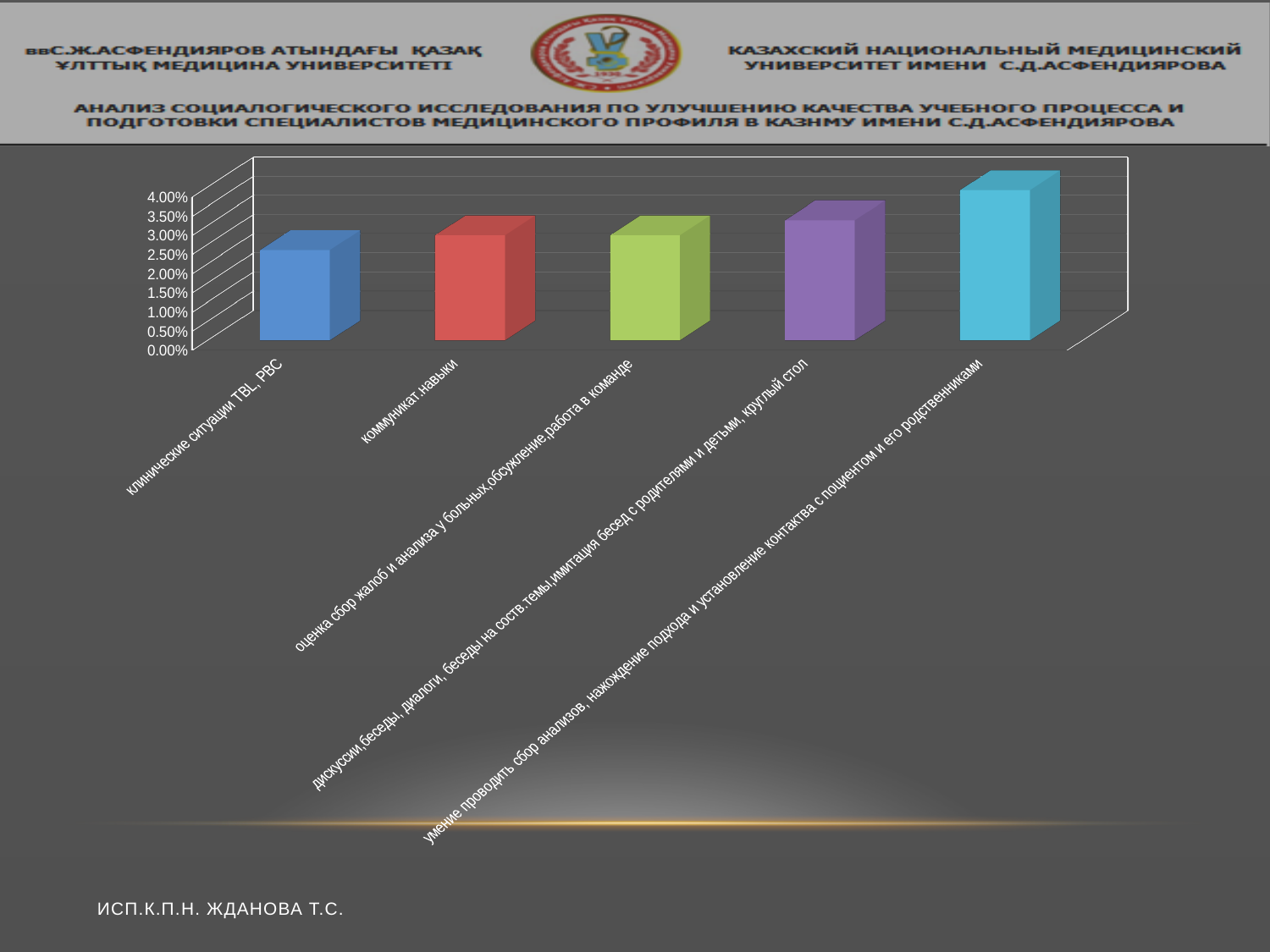
Which is larger: the value for 'клинические ситуации TBL, PBC' or the value for 'коммуникат.навыки'? коммуникат.навыки Is the value for 'умение проводить сбор анализов, нахождение подхода и установление контактва с поциентом и его родственниками' greater or less than 3.50%? greater Which category has the lowest bar? клинические ситуации TBL, PBC What is the highest value shown on the vertical axis? 4.00% Do the bar values generally rise or fall from left to right along the x axis? rise Which category has the highest bar? умение проводить сбор анализов, нажождение подхода и установление контактва с поциентом и его родственниками Is the value for 'клинические ситуации TBL, PBC' greater or less than 3.00%? less What kind of chart is shown on the slide? bar chart What colour is the bar for 'коммуникат.навыки'? red Which is larger: the value for 'дискуссии,беседы, диалоги, беседы на соств.темы,имитация бесед с родителями и детьми, круглый стол' or the value for 'клинические ситуации TBL, PBC'? дискуссии,беседы, диалоги, беседы на соств.темы,имитация бесед с родителями и детьми, круглый стол How many categories (bars) does the chart show? 5